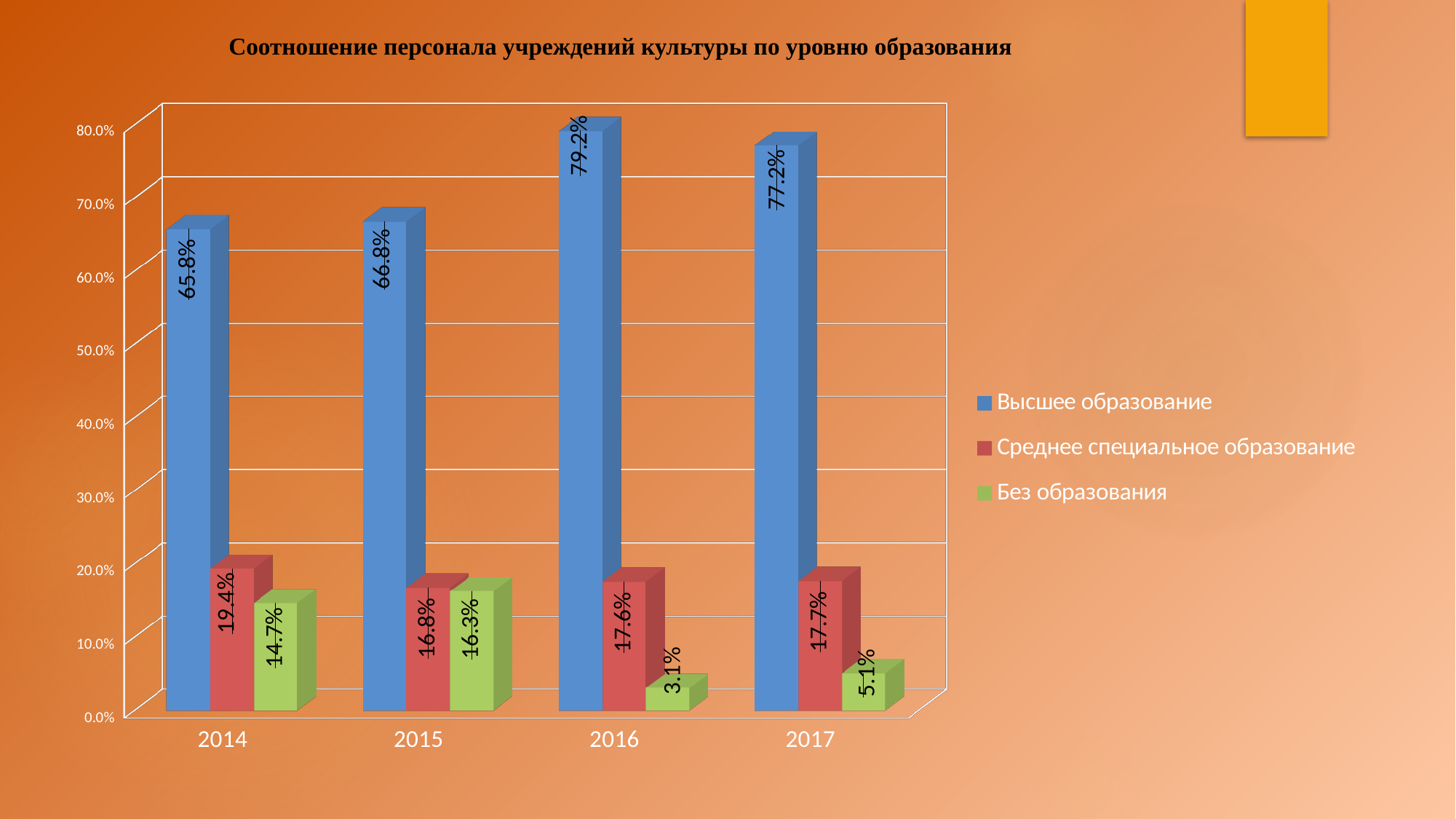
What kind of chart is shown on the slide? bar chart How many years are shown on the x axis? 4 In which year is the value for Высшее образование the highest? 2016 What is the value for Высшее образование in 2016? 79.2% What is the difference between the Высшее образование values for 2016 and 2014? 13.4% How many series does the legend list? 3 Which is larger: Среднее специальное образование in 2014 or Без образования in 2014? Среднее специальное образование in 2014 In which year is the value for Без образования the lowest? 2016 Is the value for Высшее образование in 2017 greater or less than 70.0%? greater What is the value for Без образования in 2014? 14.7% What is the value for Среднее специальное образование in 2017? 17.7% Which series is shown in green in the legend? Без образования